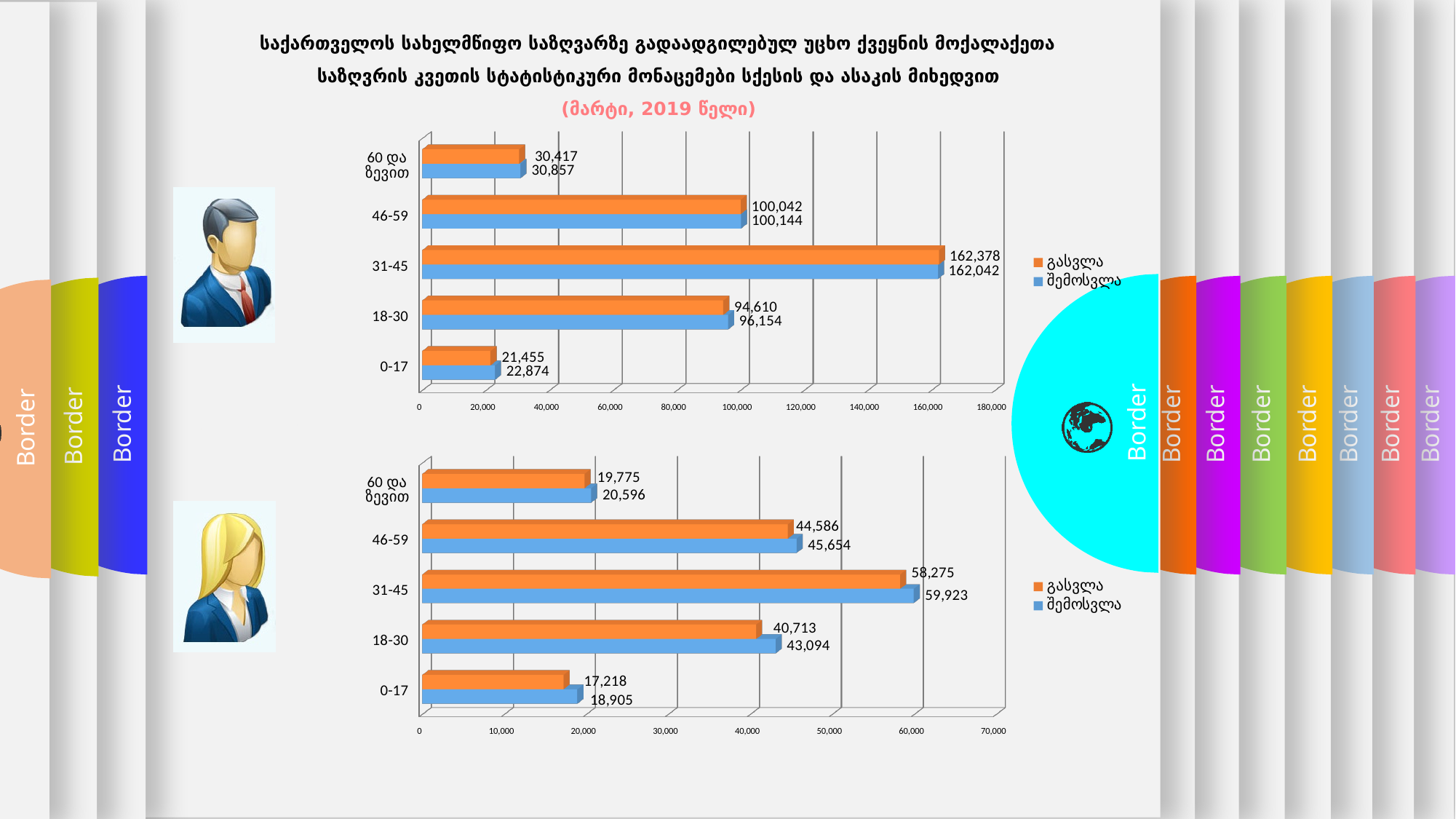
In the bottom chart, what is the შემოსვლა value for the 18-30 age group? 43,094 In the bottom chart, what is the გასვლა value for the 46-59 age group? 44,586 In the bottom chart, which age group has the lowest შემოსვლა value? 0-17 In the top chart, which is larger for the 31-45 age group, გასვლა or შემოსვლა? გასვლა What type of chart is the top chart? Bar chart In the top chart, which age group has the highest გასვლა value? 31-45 In the top chart, what is the შემოსვლა value for the 0-17 age group? 22,874 In the bottom chart, what is the difference between the შემოსვლა and გასვლა values for the 18-30 age group? 2,381 In the bottom chart, is the გასვლა value for the 31-45 age group greater or less than 50,000? greater How many series does the legend of the top chart list? 2 How many age groups are shown in the bottom chart? 5 In the top chart, what is the გასვლა value for the 31-45 age group? 162,378